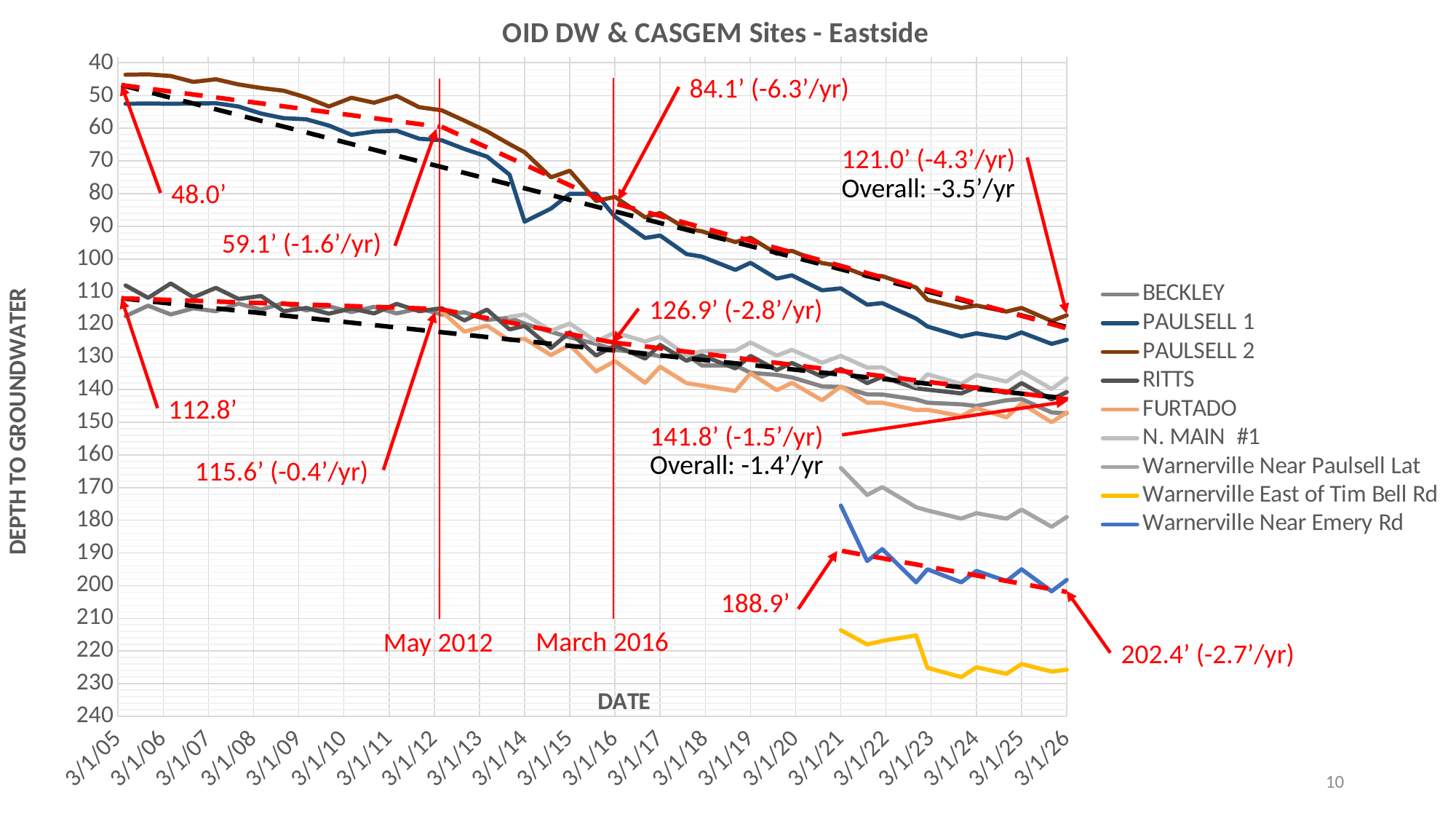
Does the depth to groundwater for PAULSELL 2 increase or decrease from 3/1/05 to 3/1/26? increase What depth and rate are annotated at the end of the lower trend line near 3/1/26? 141.8' (-1.5'/yr) Is the depth to groundwater for Warnerville East of Tim Bell Rd greater or less than 200 throughout its plotted period? greater What kind of chart is shown on the slide? line chart What is the title of the chart? OID DW & CASGEM Sites - Eastside What is the label on the vertical axis of the chart? DEPTH TO GROUNDWATER How many series does the legend list? 9 According to the annotation, what is the starting depth of the upper red trend line at 3/1/05? 48.0' What is the annotated overall rate for the upper group of wells (PAULSELL 1 / PAULSELL 2)? -3.5'/yr What depth and rate are annotated at the end of the Warnerville Near Emery Rd trend line? 202.4' (-2.7'/yr) Which series shows the greatest depth to groundwater (the lowest line on the chart)? Warnerville East of Tim Bell Rd What depth and rate are annotated for the upper trend line at March 2016? 84.1' (-6.3'/yr)